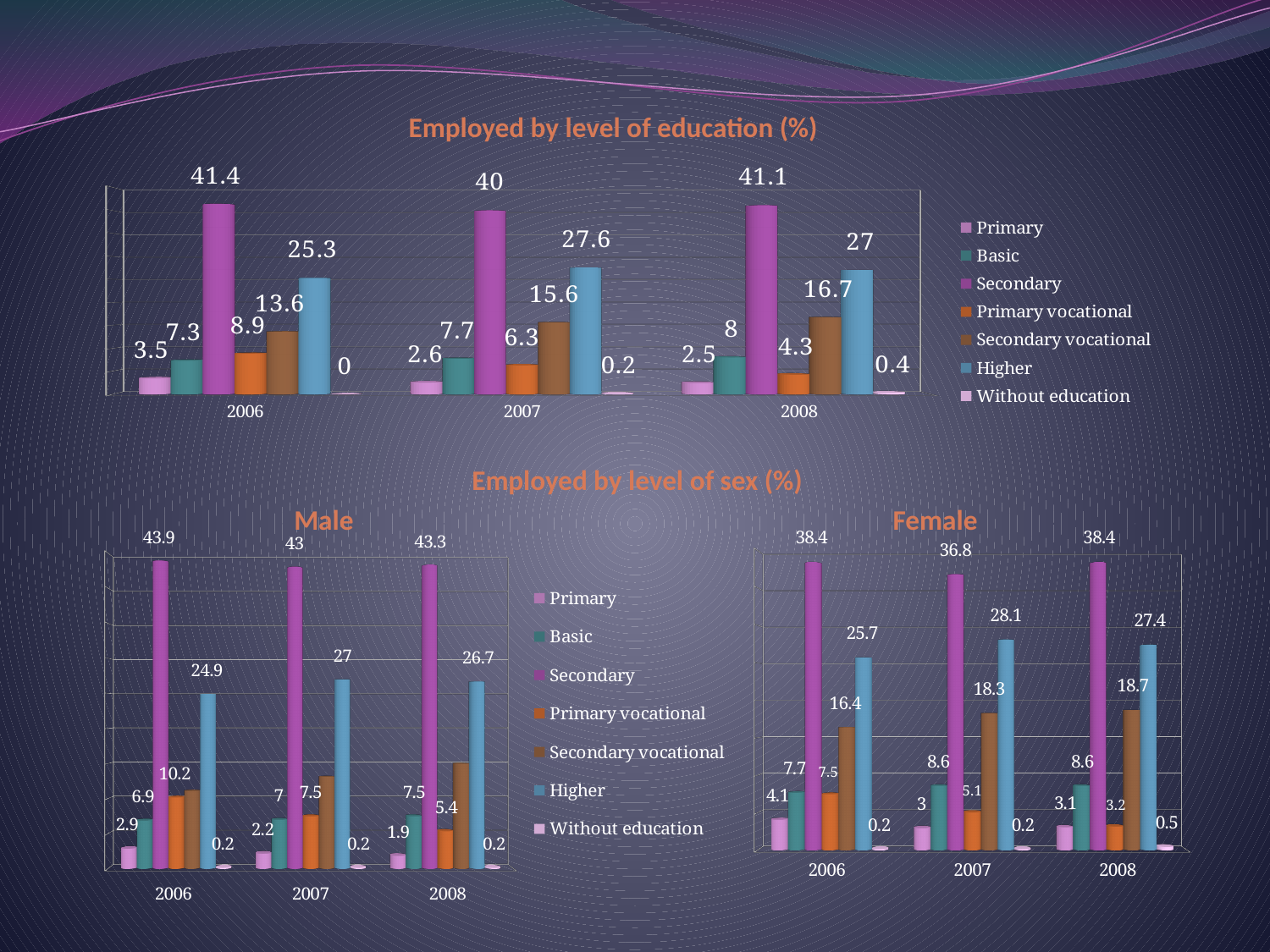
In the Female chart, what is the value for Secondary in 2007? 36.8 In the Female chart, is the Secondary value for 2006 larger or smaller than the Secondary value for 2007? Larger In the 'Employed by level of education (%)' chart, what is the value for Secondary in 2006? 41.4 In the 'Employed by level of education (%)' chart, how many series does the legend list? 7 In the 'Employed by level of education (%)' chart, which level of education has the highest value in 2008? Secondary In the Male chart, what is the value for Secondary in 2007? 43 What kind of chart is the 'Employed by level of education (%)' chart? Bar chart In the Male chart, what is the value for Higher in 2008? 26.7 In the 'Employed by level of education (%)' chart, what is the value for Secondary vocational in 2008? 16.7 In the 'Employed by level of education (%)' chart, what is the value for Higher in 2007? 27.6 In the 'Employed by level of education (%)' chart, what is the difference between the Higher values for 2007 and 2006? 2.3 In the Female chart, how many years are shown on the x axis? 3